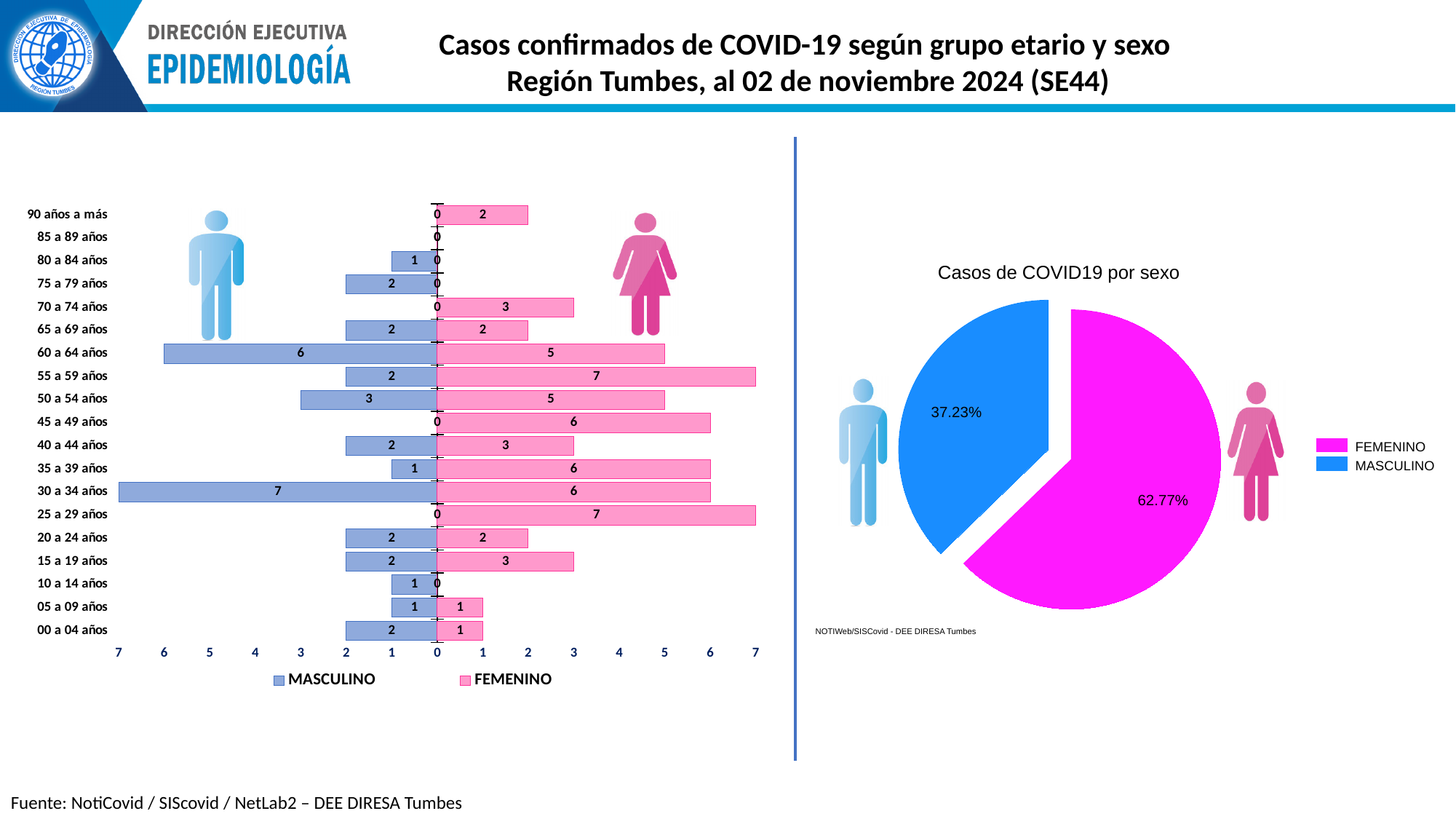
In the left bar chart, what is the difference between the FEMENINO and MASCULINO values for the 50 a 54 años age group? 2 In the left bar chart, what is the FEMENINO value for the 55 a 59 años age group? 7 In the left bar chart, what is the MASCULINO value for the 60 a 64 años age group? 6 In the left bar chart, for the 60 a 64 años age group, which series has the larger value, MASCULINO or FEMENINO? MASCULINO In the pie chart 'Casos de COVID19 por sexo', which category has the largest slice? FEMENINO What is the title of the pie chart on the right side of the slide? Casos de COVID19 por sexo What kind of chart is the chart on the left side of the slide? Bar chart In the left bar chart, which age group has the highest MASCULINO value? 30 a 34 años In the left bar chart, how many age groups are shown? 19 In the left bar chart, how many series does the legend list? 2 In the pie chart 'Casos de COVID19 por sexo', what share is FEMENINO? 62.77% In the pie chart 'Casos de COVID19 por sexo', what share is MASCULINO? 37.23%